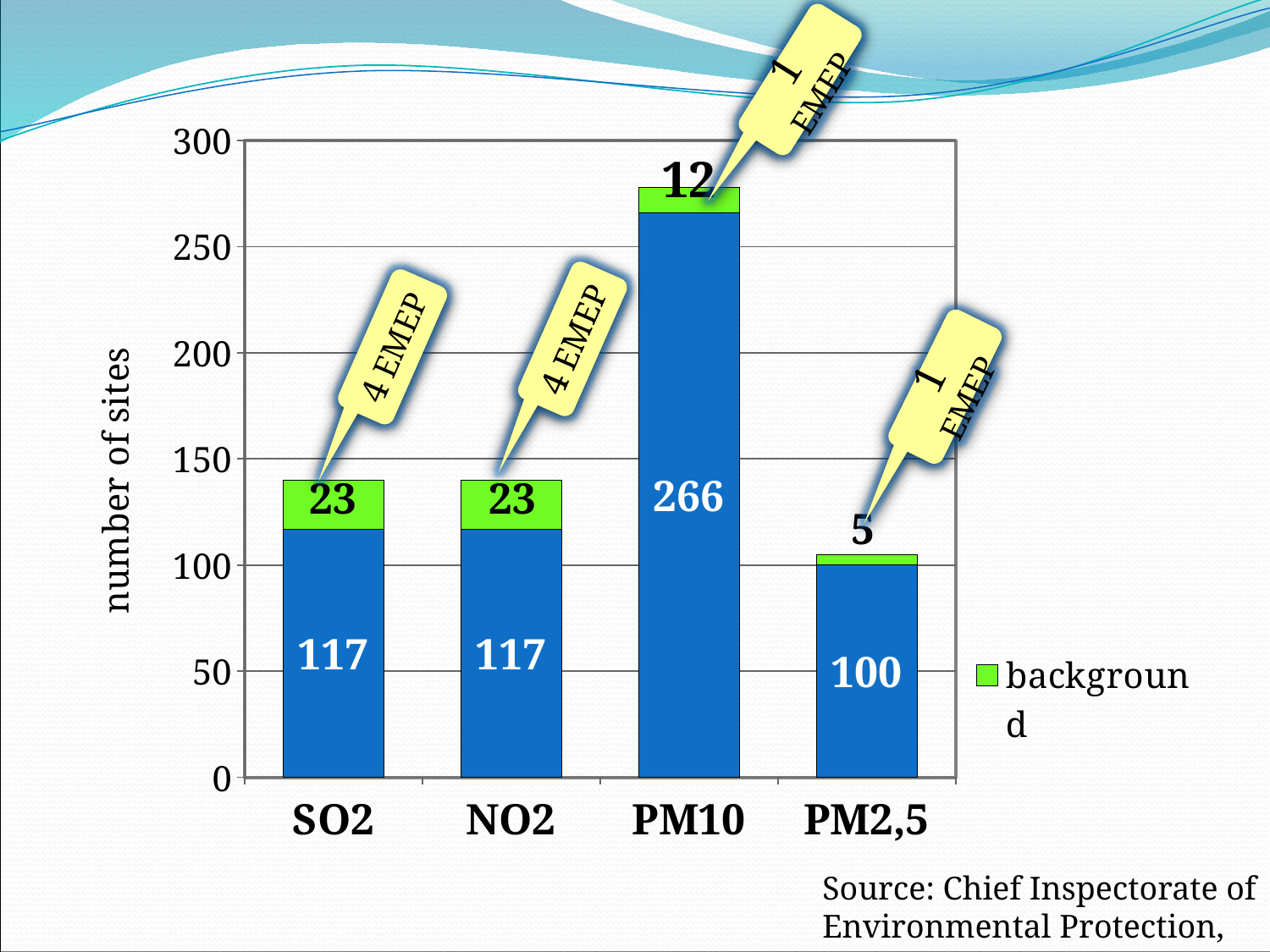
What is the label of the y axis? number of sites Which category has the tallest stacked bar? PM10 Which category has the shortest stacked bar? PM2,5 Is the total for PM10 greater or less than 250? greater What is the total of the stacked bar for PM10? 278 What kind of chart is shown on the slide? Stacked bar chart What is the background value for PM10? 12 What is the total of the stacked bar for SO2? 140 What is the value of the blue segment for PM2,5? 100 What is the difference between the blue segment values for PM10 and SO2? 149 Which has a larger background value, SO2 or PM2,5? SO2 How many categories are shown on the x axis? 4